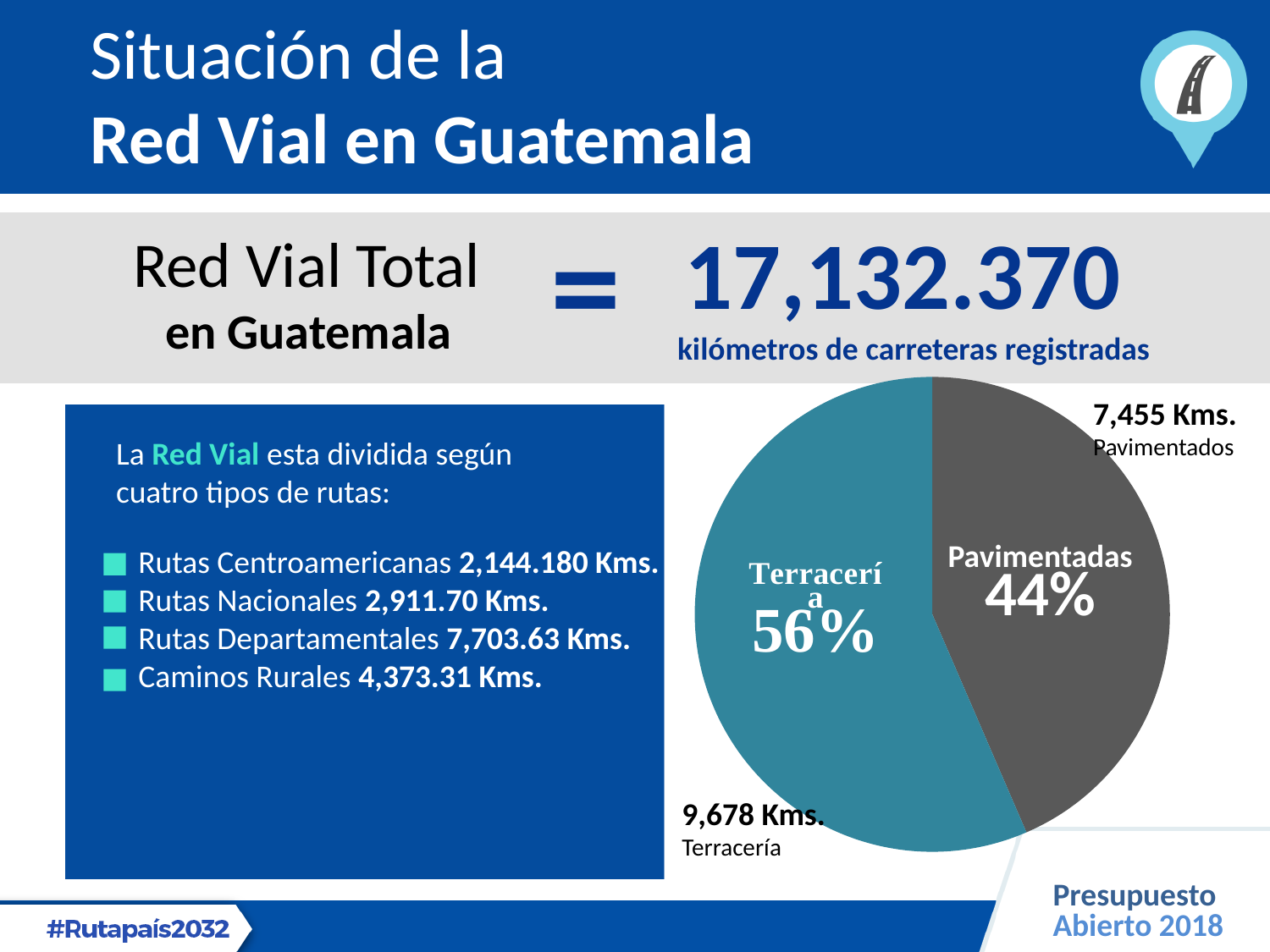
What share of the pie does Pavimentadas represent? 44% What is the difference in percentage points between the Terracería and Pavimentadas slices? 12 Which slice of the pie chart is the largest? Terracería What share of the pie does Terracería represent? 56% What kind of chart is shown on the slide? pie chart How many kilometres are labelled for Pavimentados on the pie chart? 7,455 Kms. What is the difference in kilometres between Terracería and Pavimentados as labelled on the pie chart? 2,223 Kms. What colour is the Pavimentadas slice of the pie chart? dark grey How many kilometres are labelled for Terracería on the pie chart? 9,678 Kms. How many slices does the pie chart have? 2 Which slice of the pie chart is the smallest? Pavimentadas Which is larger, the Terracería slice or the Pavimentadas slice? Terracería